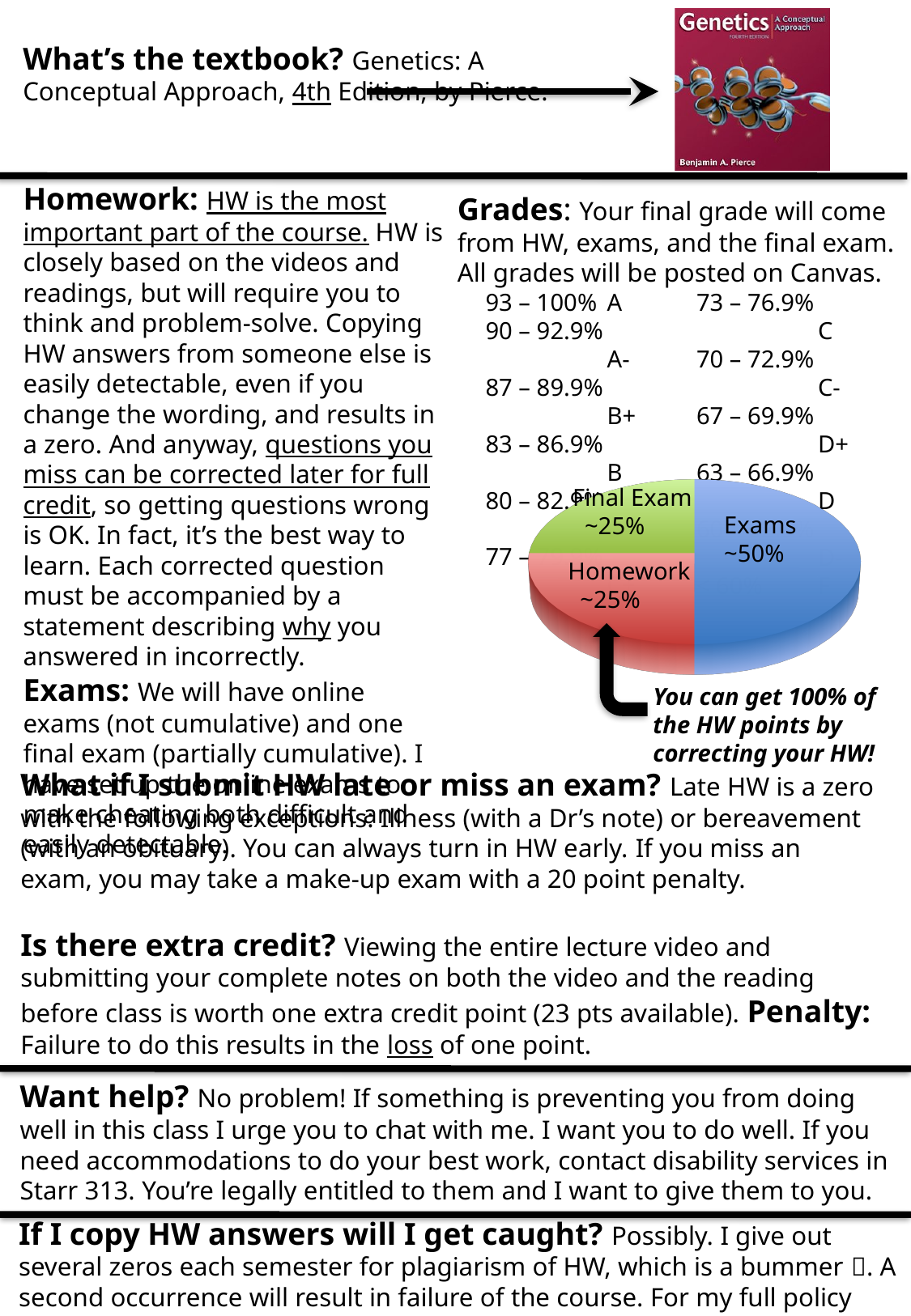
Which is larger in the pie chart, Exams or Homework? Exams What colour is the Exams slice in the pie chart? blue Which is larger in the pie chart, Exams or Final Exam? Exams What share of the final grade does the pie chart show for Final Exam? ~25% What colour is the Homework slice in the pie chart? red Which slice of the pie chart is the largest? Exams What kind of chart is shown on the slide? pie chart What share of the final grade does the pie chart show for Exams? ~50% What share of the final grade does the pie chart show for Homework? ~25% How many slices does the pie chart have? 3